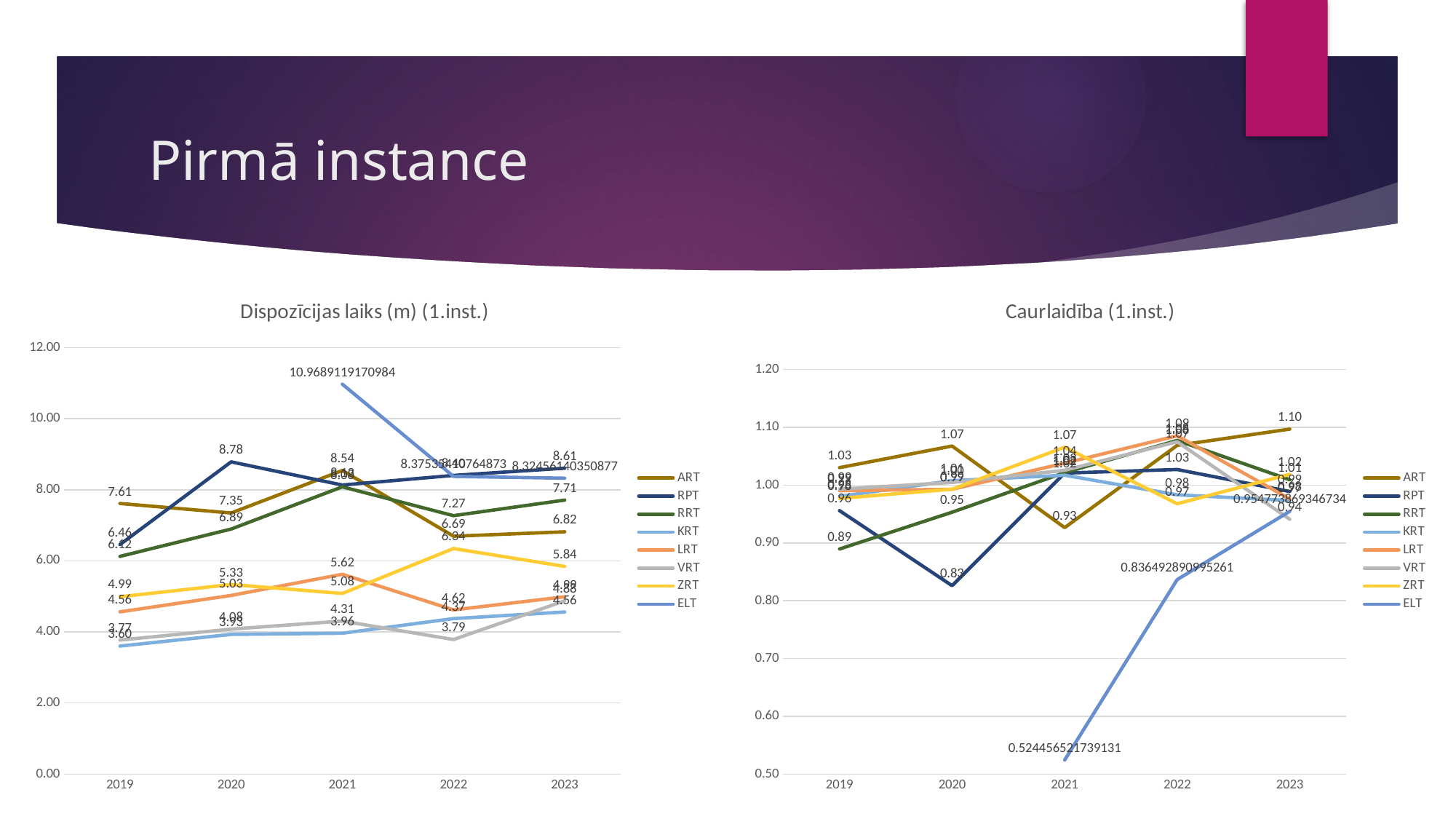
In the "Dispozīcijas laiks (m) (1.inst.)" chart, what is the value for ELT in 2021? 10.9689119170984 In the "Caurlaidība (1.inst.)" chart, what is the value for ELT in 2021? 0.524456521739131 In the "Dispozīcijas laiks (m) (1.inst.)" chart, is the value for KRT in 2019 greater or less than 4.00? less In the "Caurlaidība (1.inst.)" chart, does the ELT line rise or fall from 2021 to 2023? rise What type of chart is "Dispozīcijas laiks (m) (1.inst.)"? line chart In the "Dispozīcijas laiks (m) (1.inst.)" chart, what is the value for RPT in 2020? 8.78 In the "Caurlaidība (1.inst.)" chart, what is the value for ART in 2023? 1.10 In the "Dispozīcijas laiks (m) (1.inst.)" chart, how many series does the legend list? 8 In the "Dispozīcijas laiks (m) (1.inst.)" chart, what is the value for ZRT in 2022? 6.34 How many years are shown on the x axis of the "Caurlaidība (1.inst.)" chart? 5 In the "Caurlaidība (1.inst.)" chart, which series has the lowest value in 2020? RPT In the "Dispozīcijas laiks (m) (1.inst.)" chart, which series has the highest value in 2021? ELT